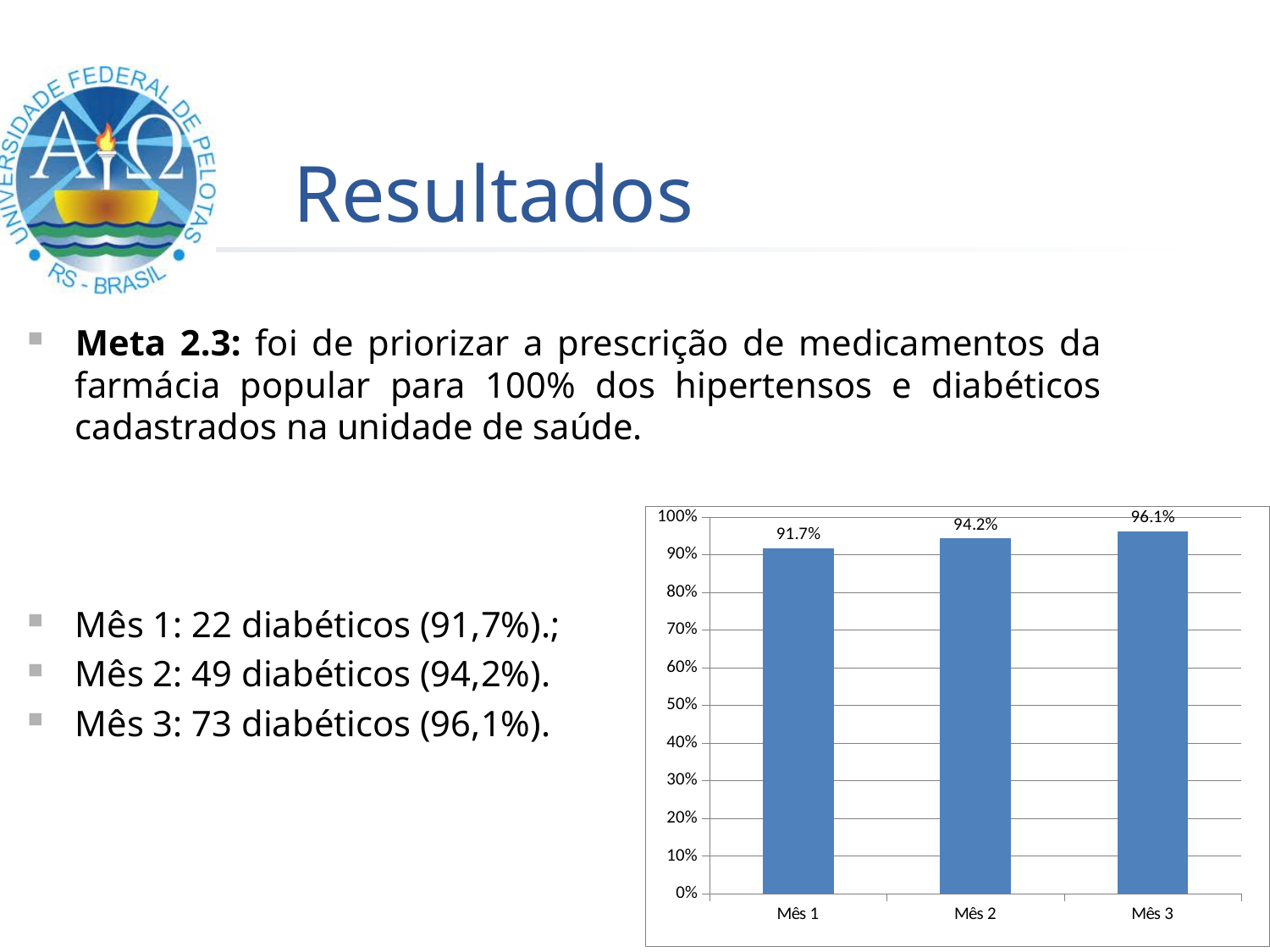
What is the difference between the values for Mês 3 and Mês 1? 4.4% Which month has the lowest value? Mês 1 What is the value for Mês 3? 96.1% What kind of chart is shown on the slide? bar chart Is the value for Mês 1 greater or less than 90%? greater Do the values rise or fall from Mês 1 to Mês 3? rise Which is larger, the value for Mês 2 or the value for Mês 3? Mês 3 What is the value for Mês 1? 91.7% How many categories are shown on the x axis? 3 What is the value for Mês 2? 94.2% What is the difference between the values for Mês 2 and Mês 1? 2.5% Which month has the highest value? Mês 3